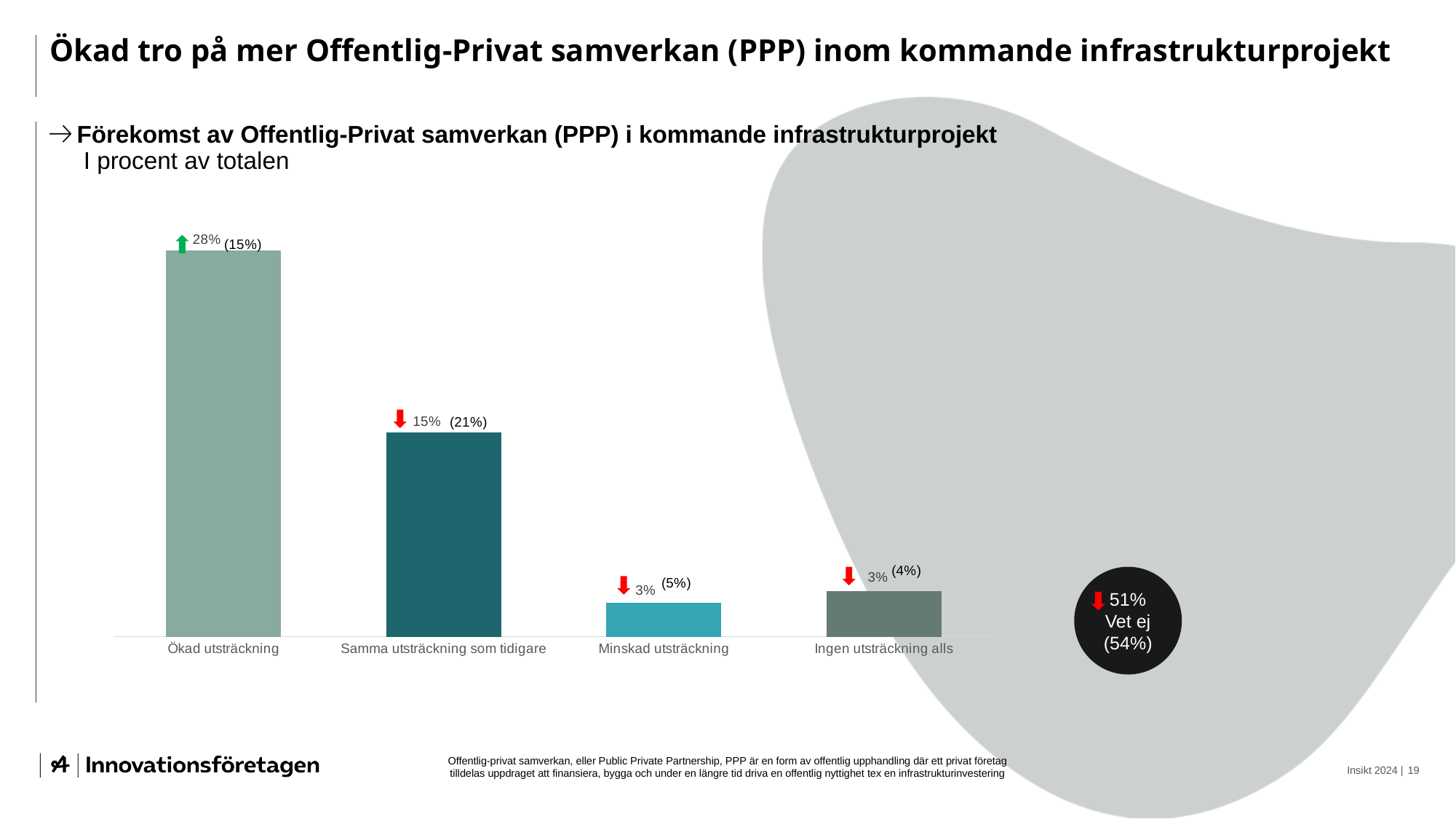
What is the value for "Minskad utsträckning"? 3% What is the value for "Ökad utsträckning"? 28% What is the previous-year value shown in parentheses for "Samma utsträckning som tidigare"? 21% What percentage is shown in the "Vet ej" circle? 51% What kind of chart is shown on the slide? Bar chart What is the subtitle text below the chart heading describing the unit? I procent av totalen Which is larger, the value for "Ökad utsträckning" or for "Samma utsträckning som tidigare"? Ökad utsträckning How many categories are shown on the x axis of the bar chart? 4 Which category has the highest value? Ökad utsträckning What is the difference between the values for "Ökad utsträckning" and "Samma utsträckning som tidigare"? 13% What is the previous-year value shown in parentheses for "Ökad utsträckning"? 15% What is the value for "Samma utsträckning som tidigare"? 15%